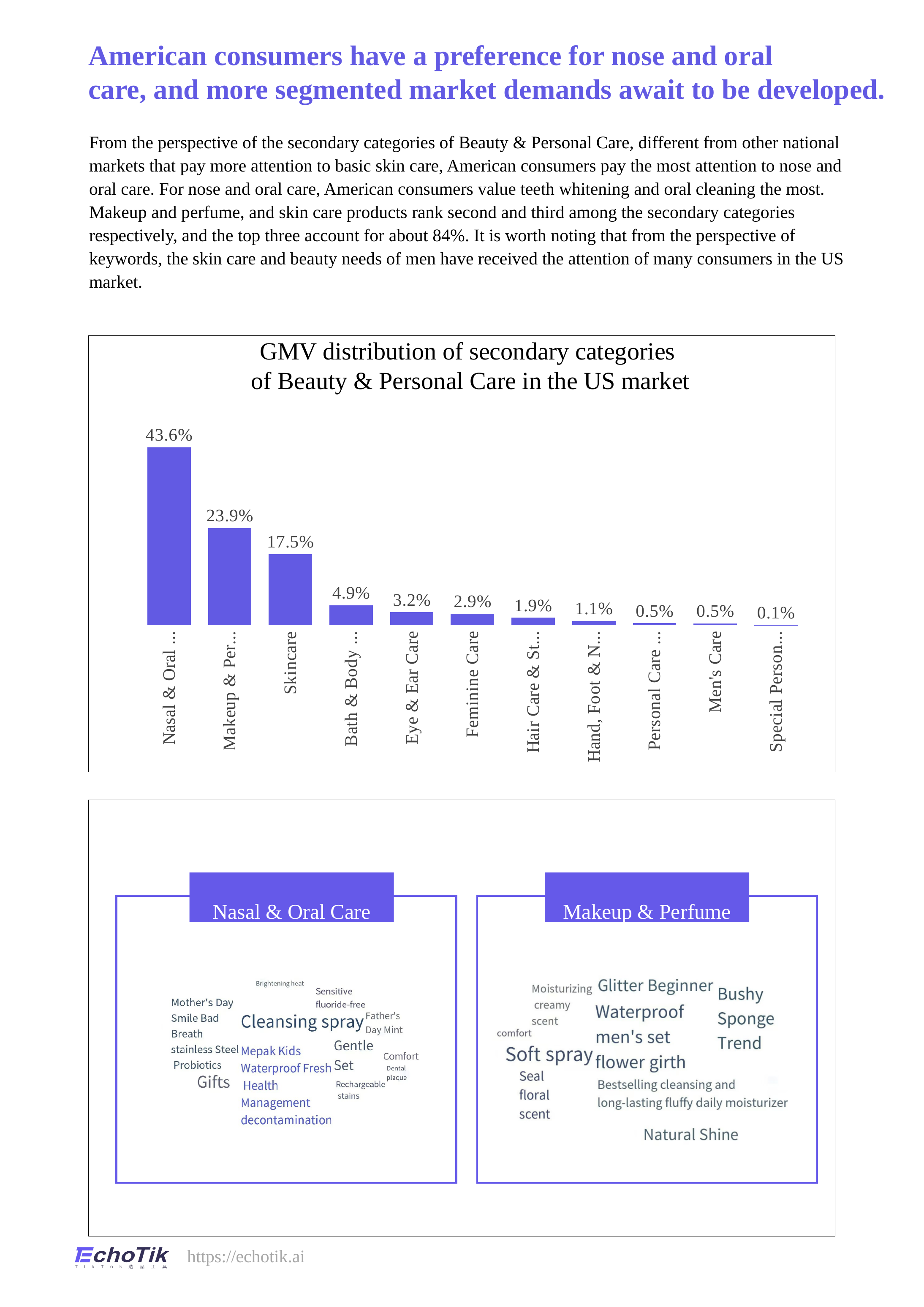
How many categories are shown in the bar chart? 11 What is the title of the bar chart? GMV distribution of secondary categories of Beauty & Personal Care in the US market What type of chart is shown on the slide? bar chart What is the difference in GMV share between the Nasal & Oral category and the Makeup & Perfume category? 19.7% Which has a larger GMV share, Feminine Care or Eye & Ear Care? Eye & Ear Care Which category has the highest GMV share? Nasal & Oral Care What is the GMV share for Eye & Ear Care? 3.2% What is the GMV share for Skincare? 17.5% What is the GMV share for Men's Care? 0.5% Which category has the lowest GMV share? Special Person... What is the difference in GMV share between Skincare and Eye & Ear Care? 14.3% What is the GMV share for Feminine Care? 2.9%